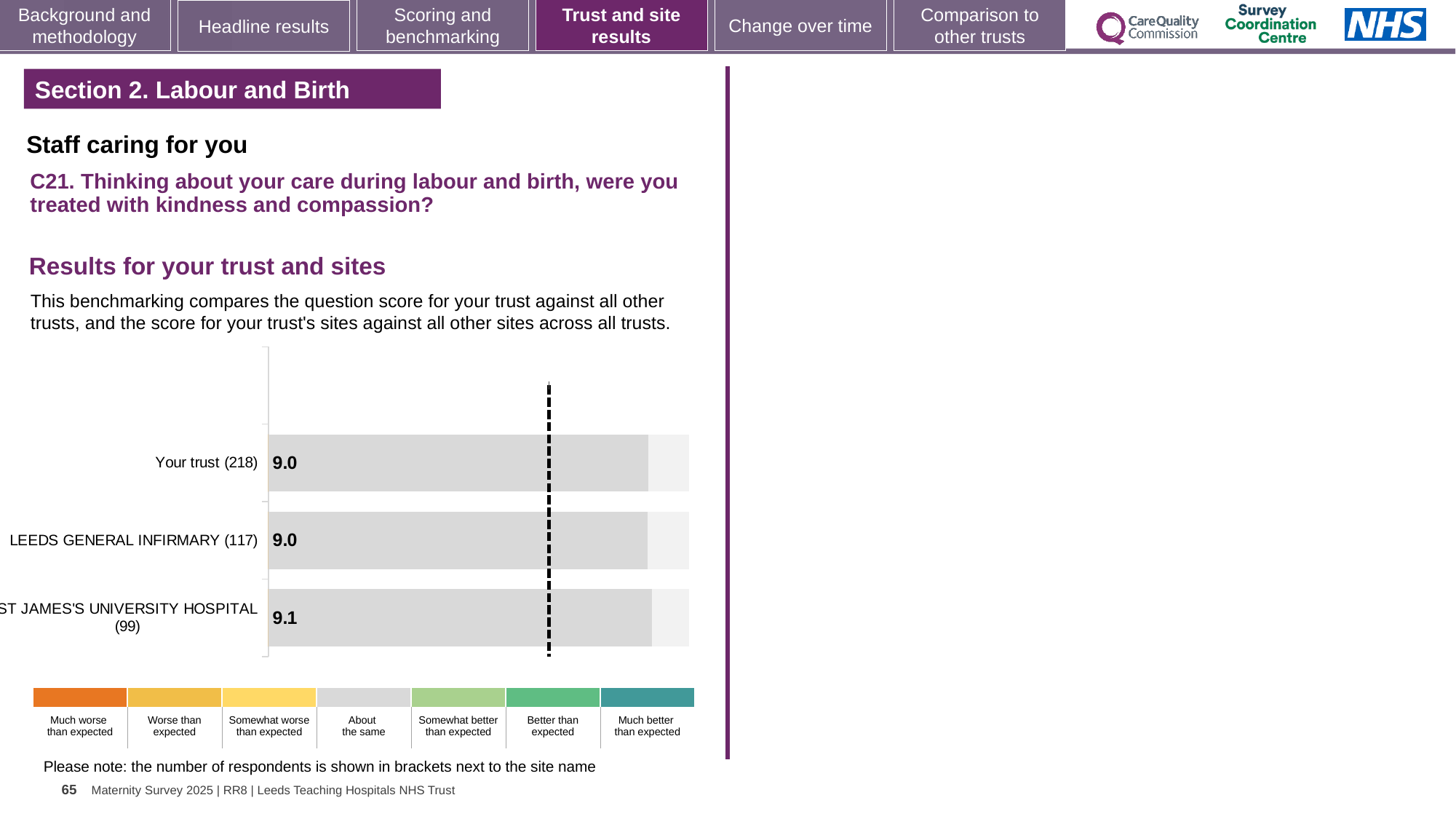
What is the difference between the score for St James's University Hospital and the score for Leeds General Infirmary? 0.1 Which is larger, the score for St James's University Hospital or the score for Your trust? St James's University Hospital How many respondents are shown in brackets for St James's University Hospital? 99 What is the score for Leeds General Infirmary? 9.0 How many respondents are shown in brackets for Your trust? 218 How many categories does the colour key below the chart list? 7 How many bars are plotted on the chart? 3 What is the score for St James's University Hospital? 9.1 Which site or trust has the highest score on the chart? St James's University Hospital Which colour-key category do the grey bars on the chart correspond to? About the same What is the score for Your trust? 9.0 What kind of chart is shown on the slide? Bar chart